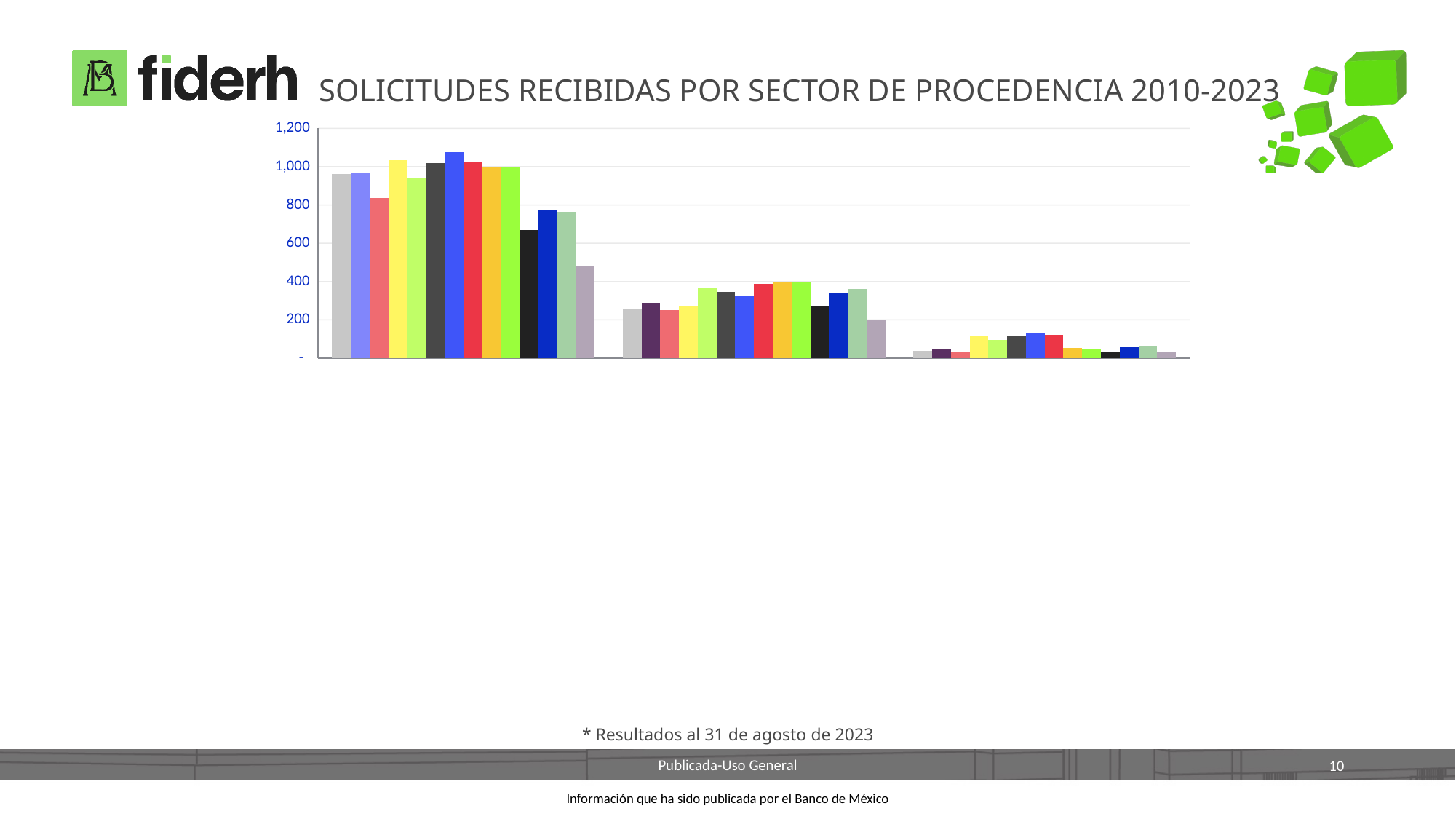
What is the title of the chart on the slide? SOLICITUDES RECIBIDAS POR SECTOR DE PROCEDENCIA 2010-2023 What kind of chart is shown on the slide? bar chart Is the tallest bar in the rightmost group of the chart greater or less than 200? less Is the last (rightmost) bar of the leftmost group greater or less than 600? less How many groups of bars does the chart show? 3 Is the tallest bar in the middle group of the chart greater or less than 600? less Which group of bars in the chart has the highest values: the leftmost, middle, or rightmost? leftmost What is the highest value shown on the vertical axis of the chart? 1,200 Which group of bars in the chart has the lowest values: the leftmost, middle, or rightmost? rightmost How many bars are in each group of the chart? 14